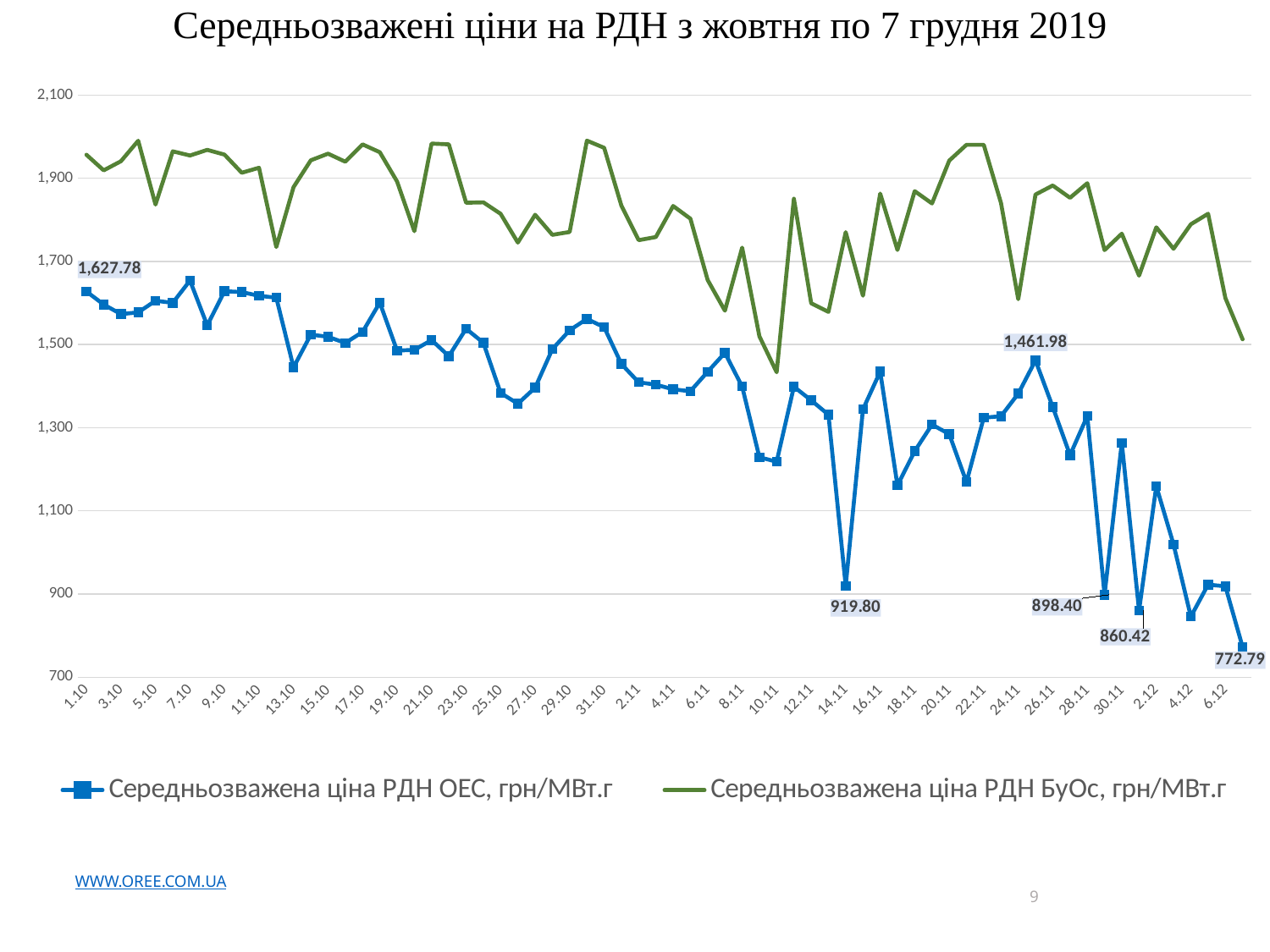
Which series has the higher value at 1.10, ОЕС or БуОс? БуОс What is the labelled value of the 'Середньозважена ціна РДН ОЕС' series at the peak near 26.11? 1,461.98 What kind of chart is shown on the slide? line chart How many series does the legend list? 2 Overall, does the 'Середньозважена ціна РДН ОЕС' series rise or fall from 1.10 to the end of the period? fall What is the labelled value of the 'Середньозважена ціна РДН ОЕС' series at the dip near 14.11? 919.80 What is the title of the chart? Середньозважені ціни на РДН з жовтня по 7 грудня 2019 What is the labelled value at the last point of the 'Середньозважена ціна РДН ОЕС' series? 772.79 What is the difference between the labelled value at 1.10 (1,627.78) and the labelled value at the last point (772.79) of the ОЕС series? 854.99 Is the value of the 'Середньозважена ціна РДН БуОс' series at 1.10 greater or less than 1,900? greater What is the labelled value of the 'Середньозважена ціна РДН ОЕС' series at 1.10? 1,627.78 What is the difference between the labelled values 1,461.98 and 919.80 on the ОЕС series? 542.18